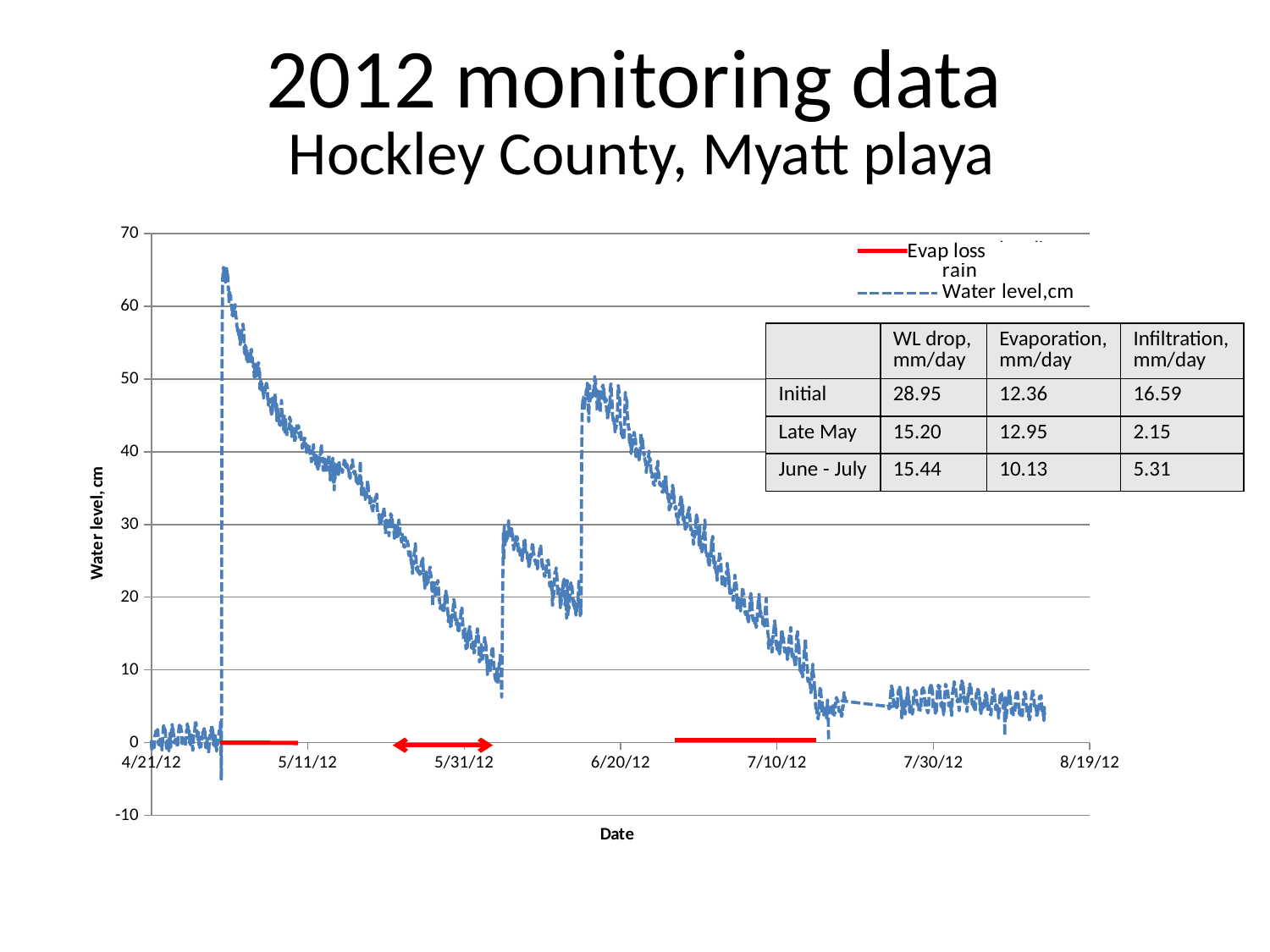
Is the water level around 6/20/12 greater or less than 40? greater What is the label of the y axis of the chart? Water level, cm In the table on the chart, what is the WL drop in mm/day for the Initial period? 28.95 Does the water level rise or fall between 5/11/12 and 5/31/12? fall What is the label of the x axis of the chart? Date Is the water level around 5/31/12 greater or less than 20? less In the table on the chart, what is the Infiltration in mm/day for Late May? 2.15 Does the water level rise or fall between 6/20/12 and 7/10/12? fall Is the highest water level reached on the chart greater or less than 60? greater What kind of chart is shown on the slide? line chart How many series does the chart legend list? 2